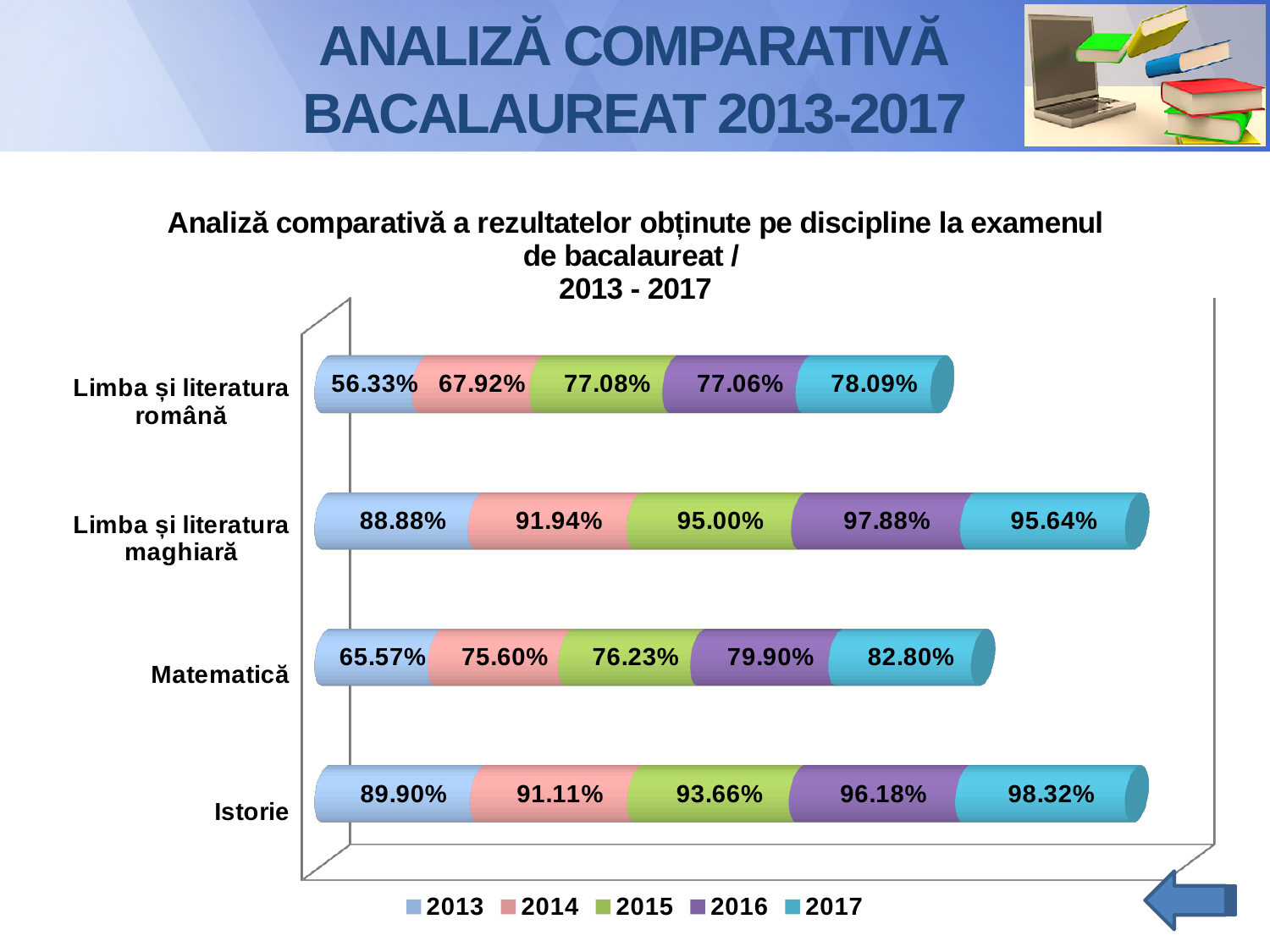
What is the value for Matematică in 2017? 82.80% Do the values for Istorie rise or fall from 2013 to 2017? Rise Which subject has the lowest value in 2013? Limba și literatura română What is the value for Istorie in 2013? 89.90% How many subjects are shown on the chart? 4 What kind of chart is shown on the slide? Stacked bar chart What is the value for Limba și literatura română in 2015? 77.08% For Limba și literatura maghiară, which year has the larger value, 2016 or 2017? 2016 How many series does the legend list? 5 What is the total of the stacked bar for Istorie? 469.17% Which subject has the highest value in 2017? Istorie By how many percentage points did the value for Matematică increase from 2013 to 2017? 17.23